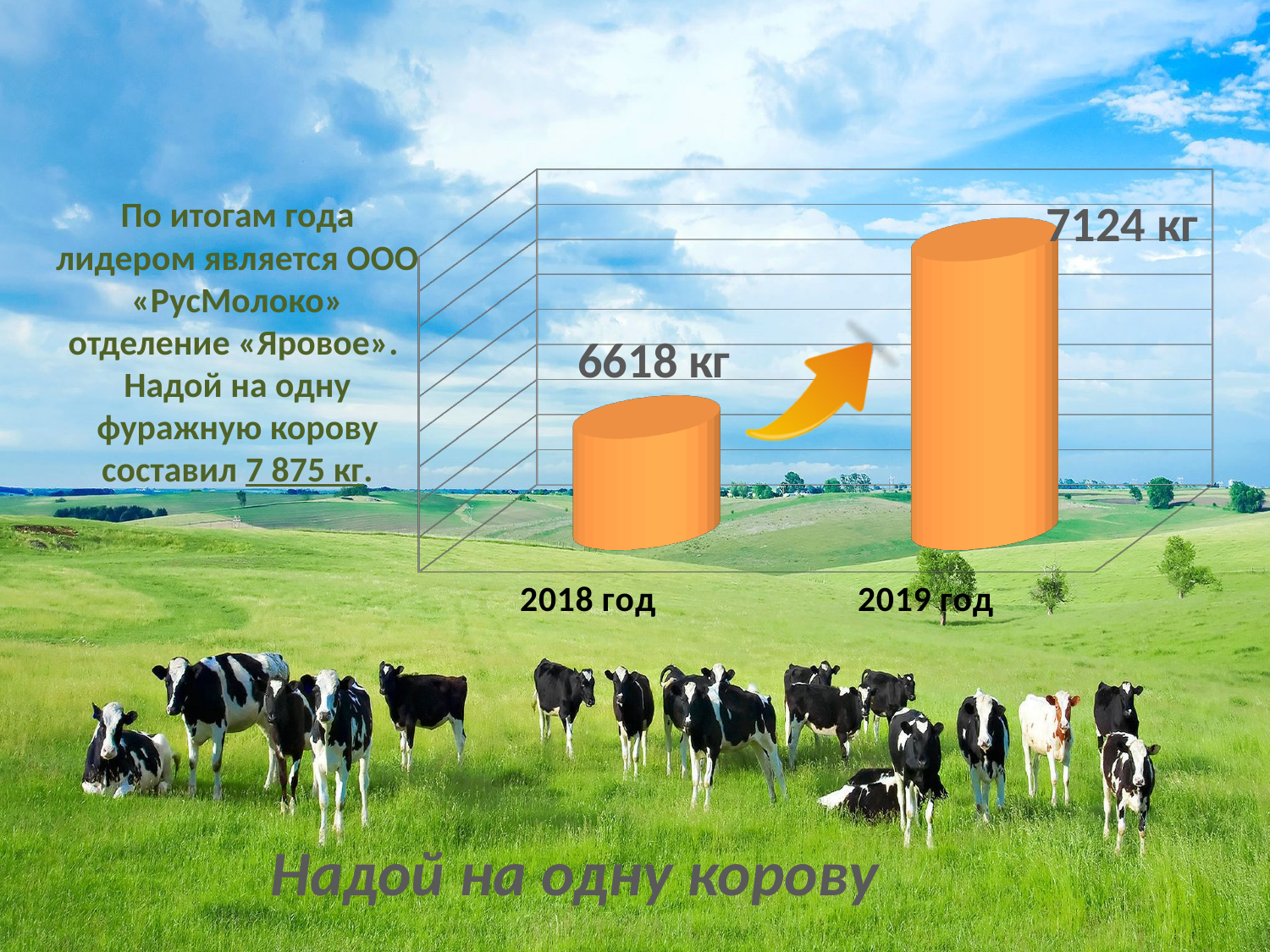
What is the difference between the 2019 год and 2018 год values? 506 кг Is the value for 2019 год larger or smaller than the value for 2018 год? larger Do the values rise or fall from 2018 год to 2019 год? rise What kind of chart is shown on the slide? bar chart What is the value for 2018 год? 6618 кг How many categories are shown on the chart? 2 What is the value for 2019 год? 7124 кг What colour are the bars on the chart? orange Which year has the lower value? 2018 год Which year has the higher value? 2019 год What is the title of the chart at the bottom of the slide? Надой на одну корову